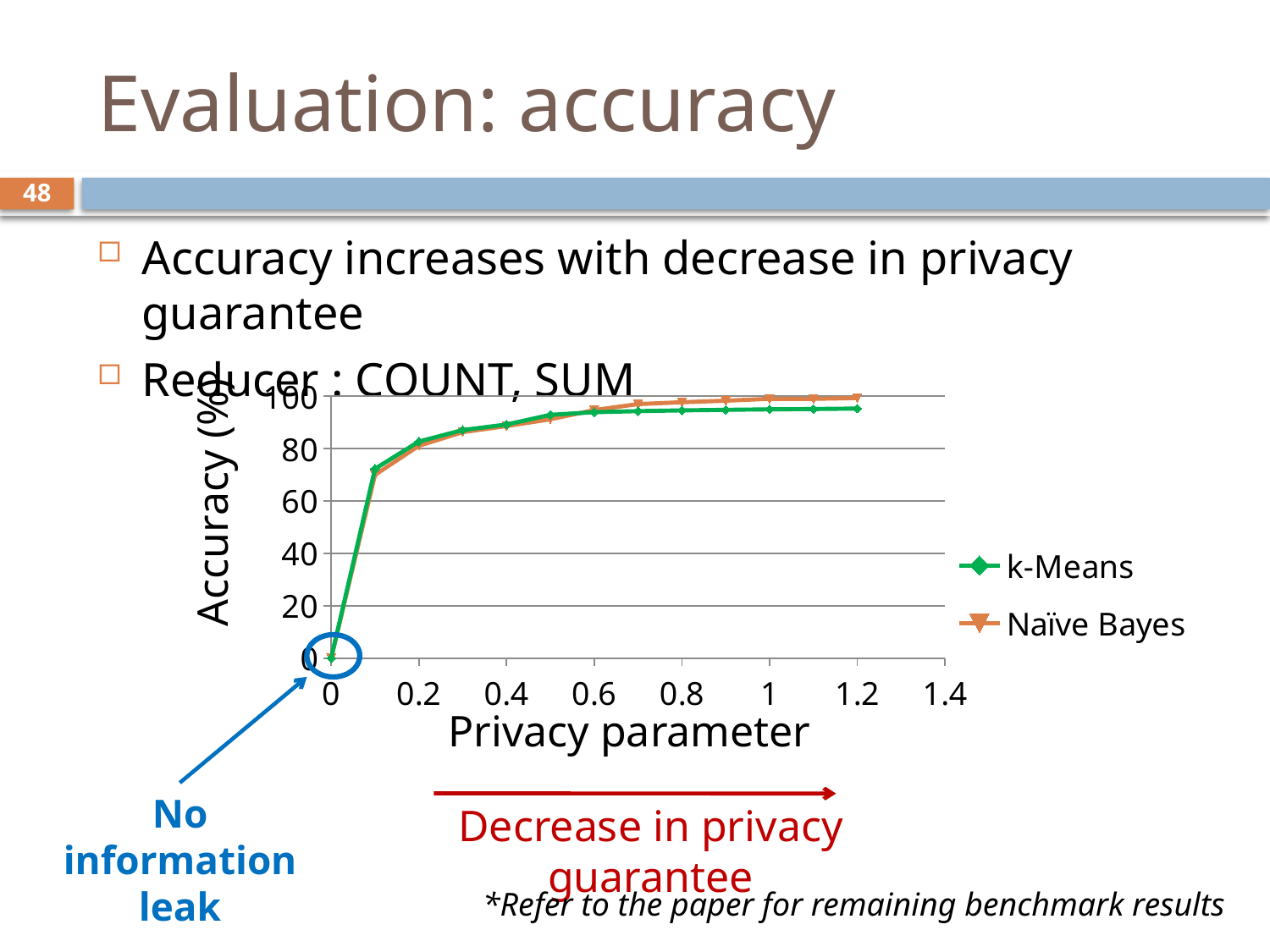
Is the accuracy of Naïve Bayes at privacy parameter 1.2 greater or less than 80? greater At which privacy parameter is the accuracy of Naïve Bayes lowest? 0 What is the label of the chart's x axis? Privacy parameter At privacy parameter 1.2, which series has the higher accuracy, k-Means or Naïve Bayes? Naïve Bayes Do the accuracy values rise or fall as the privacy parameter increases along the x axis? rise How many series does the chart's legend list? 2 Is the accuracy of Naïve Bayes at privacy parameter 0.2 greater or less than 60? greater Is the accuracy of k-Means at privacy parameter 0.1 greater or less than 80? less What is the accuracy of k-Means at privacy parameter 0? 0 What are the two series named in the chart's legend? k-Means and Naïve Bayes What kind of chart is shown on the slide? line chart